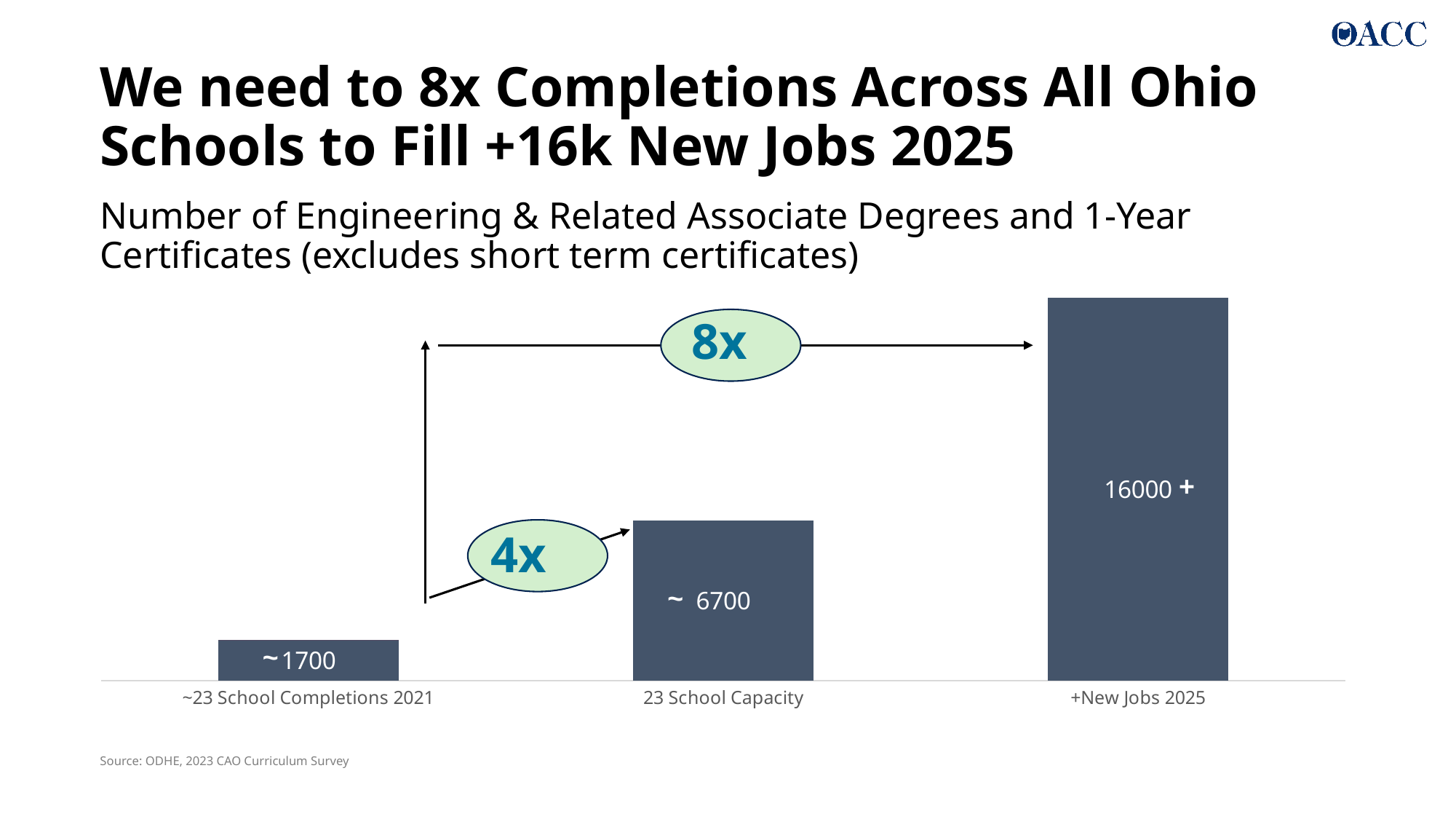
Which category has the tallest bar? +New Jobs 2025 Which is larger, the bar for 23 School Capacity or the bar for ~23 School Completions 2021? 23 School Capacity What multiplier is shown in the oval annotation between the ~23 School Completions 2021 bar and the 23 School Capacity bar? 4x What value is labelled on the bar for ~23 School Completions 2021? ~1700 What value is labelled on the bar for +New Jobs 2025? 16000 + What kind of chart is shown on the slide? Bar chart How many bars are shown in the chart? 3 What value is labelled on the bar for 23 School Capacity? ~ 6700 Do the bar values rise or fall from left to right across the chart? Rise What multiplier is shown in the oval annotation pointing to the +New Jobs 2025 bar? 8x Which category has the shortest bar? ~23 School Completions 2021